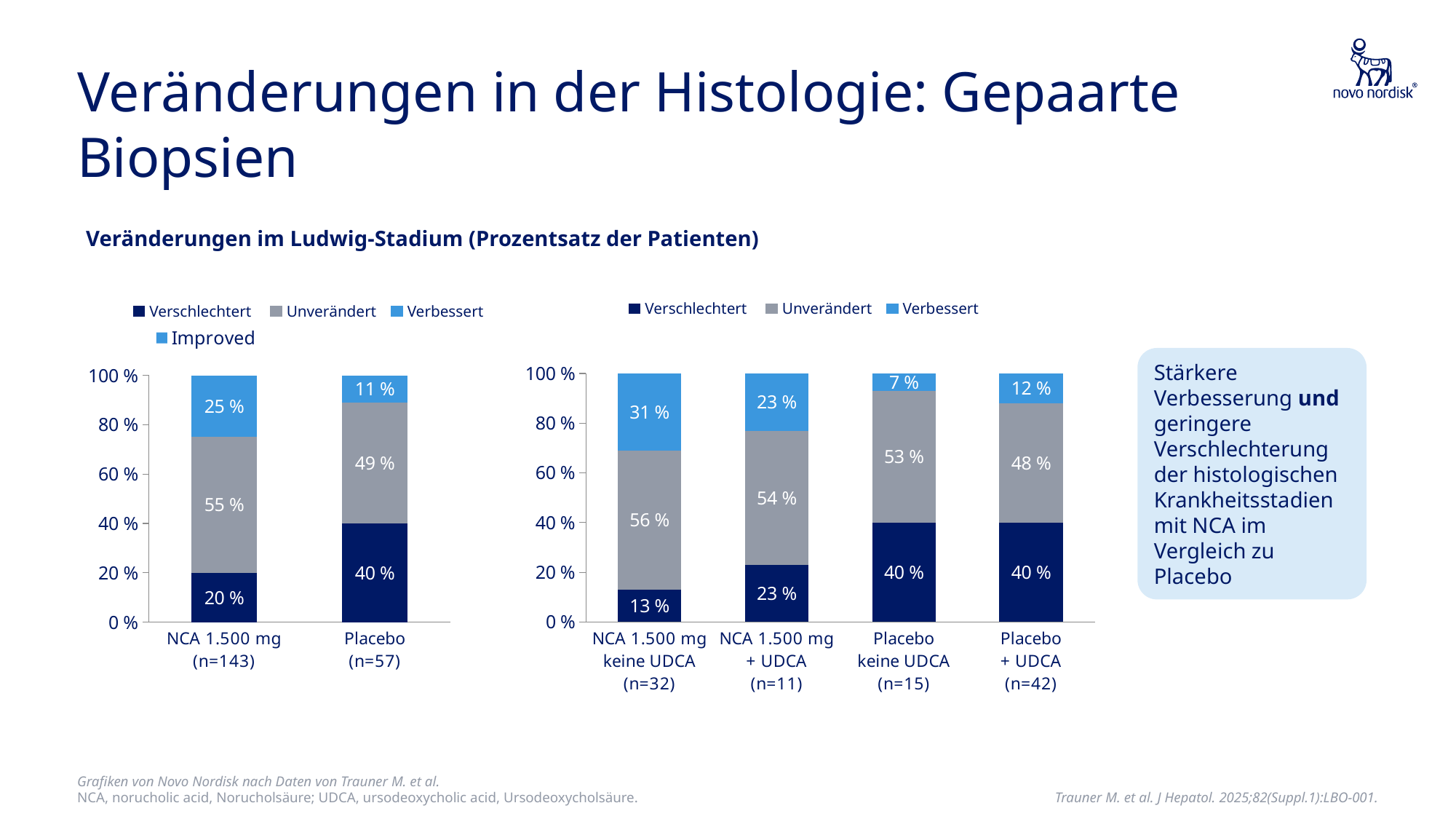
How many entries does the legend of the right chart list? 3 In the left chart, what percentage of patients in the Placebo (n=57) group are Verbessert? 11 % In the right chart, what percentage of patients in the NCA 1.500 mg keine UDCA (n=32) group are Verbessert? 31 % In the right chart, which is larger: the Verschlechtert percentage for NCA 1.500 mg + UDCA (n=11) or for Placebo + UDCA (n=42)? Placebo + UDCA (n=42) In the right chart, what percentage of patients in the Placebo + UDCA (n=42) group are Unverändert? 48 % In the right chart, what is the difference in the Unverändert percentage between NCA 1.500 mg keine UDCA (n=32) and Placebo keine UDCA (n=15)? 3 % In the left chart, what is the difference in the Verbessert percentage between NCA 1.500 mg (n=143) and Placebo (n=57)? 14 % In the right chart, which group has the lowest Verbessert percentage? Placebo keine UDCA (n=15) What type of chart is the left chart? Stacked bar chart In the right chart, which group has the lowest Verschlechtert percentage? NCA 1.500 mg keine UDCA (n=32) In the left chart, what percentage of patients in the NCA 1.500 mg (n=143) group are Verschlechtert? 20 % How many groups (bars) are shown in the right chart? 4